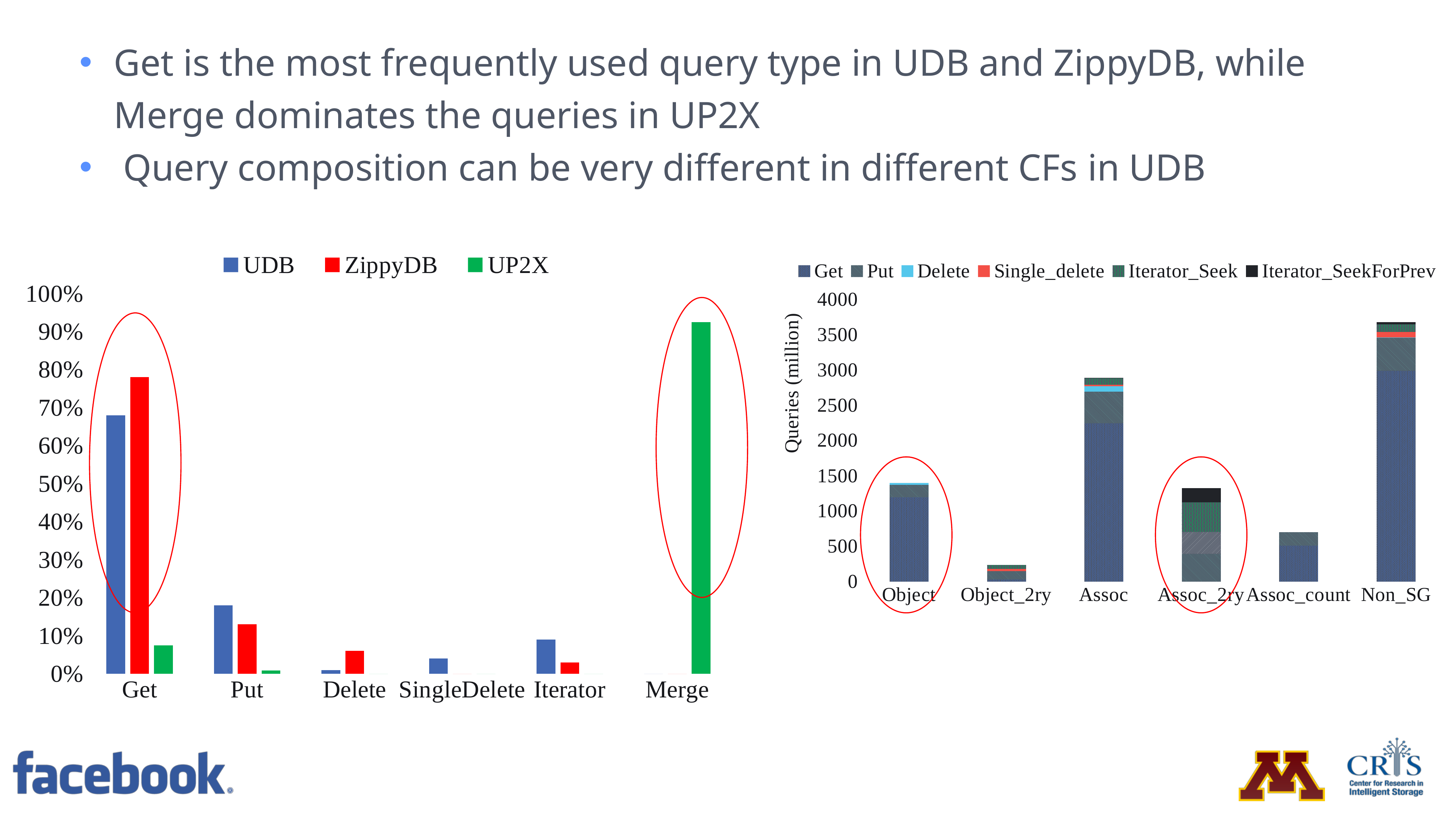
In the right chart, which column family has the shortest stacked bar? Object_2ry In the left chart, which series has the highest value for Get? ZippyDB What kind of chart is the left chart with the UDB, ZippyDB and UP2X legend? bar chart In the left chart, how many query types are shown on the x axis? 6 In the right chart, which column family has the tallest stacked bar? Non_SG In the left chart, how many series does the legend list? 3 In the left chart, which is larger for Put: the UDB value or the ZippyDB value? UDB In the right chart, what is the label of the y axis? Queries (million) In the right chart, how many series does the legend list? 6 In the left chart, is the UDB value for Get greater or less than 60%? greater In the left chart, is the UP2X value for Merge greater or less than 90%? greater In the left chart, which query type has the highest value for UP2X? Merge